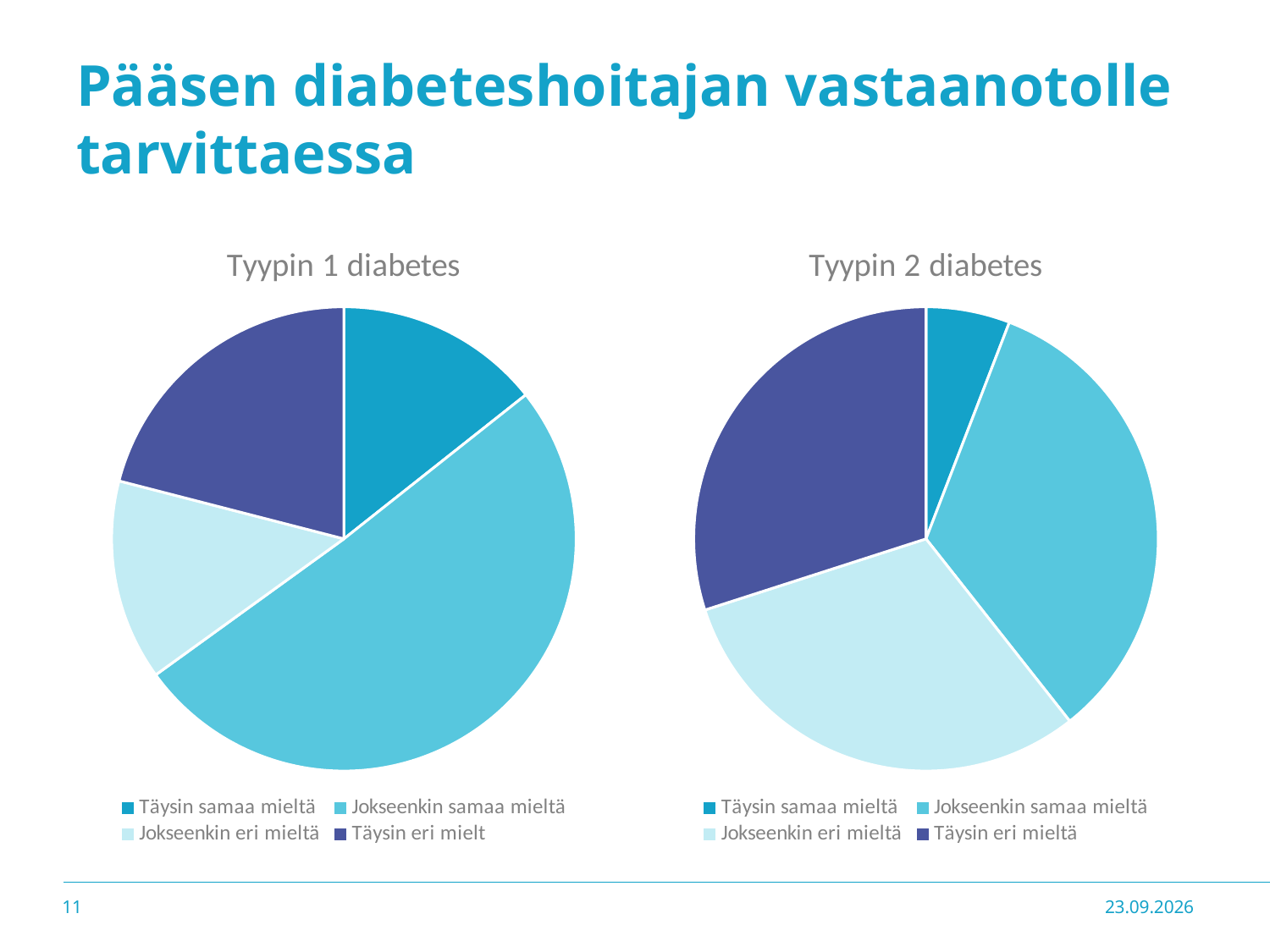
What is the title of the pie chart on the right side of the slide? Tyypin 2 diabetes How many entries does the legend of the "Tyypin 2 diabetes" chart list? 4 In the "Tyypin 2 diabetes" chart, which slice is larger: Täysin samaa mieltä or Jokseenkin eri mieltä? Jokseenkin eri mieltä How many slices does the "Tyypin 2 diabetes" pie chart have? 4 In the "Tyypin 1 diabetes" chart, which category has the largest slice? Jokseenkin samaa mieltä In the "Tyypin 1 diabetes" chart, which legend entry is shown in the darkest blue colour? Täysin eri mielt Which chart has the larger Täysin samaa mieltä slice, "Tyypin 1 diabetes" or "Tyypin 2 diabetes"? Tyypin 1 diabetes How many slices does the "Tyypin 1 diabetes" pie chart have? 4 In the "Tyypin 2 diabetes" chart, which category has the smallest slice? Täysin samaa mieltä What kind of chart is the "Tyypin 2 diabetes" chart? Pie chart In the "Tyypin 1 diabetes" chart, which slice is larger: Jokseenkin samaa mieltä or Täysin eri mielt? Jokseenkin samaa mieltä What kind of chart is the "Tyypin 1 diabetes" chart? Pie chart